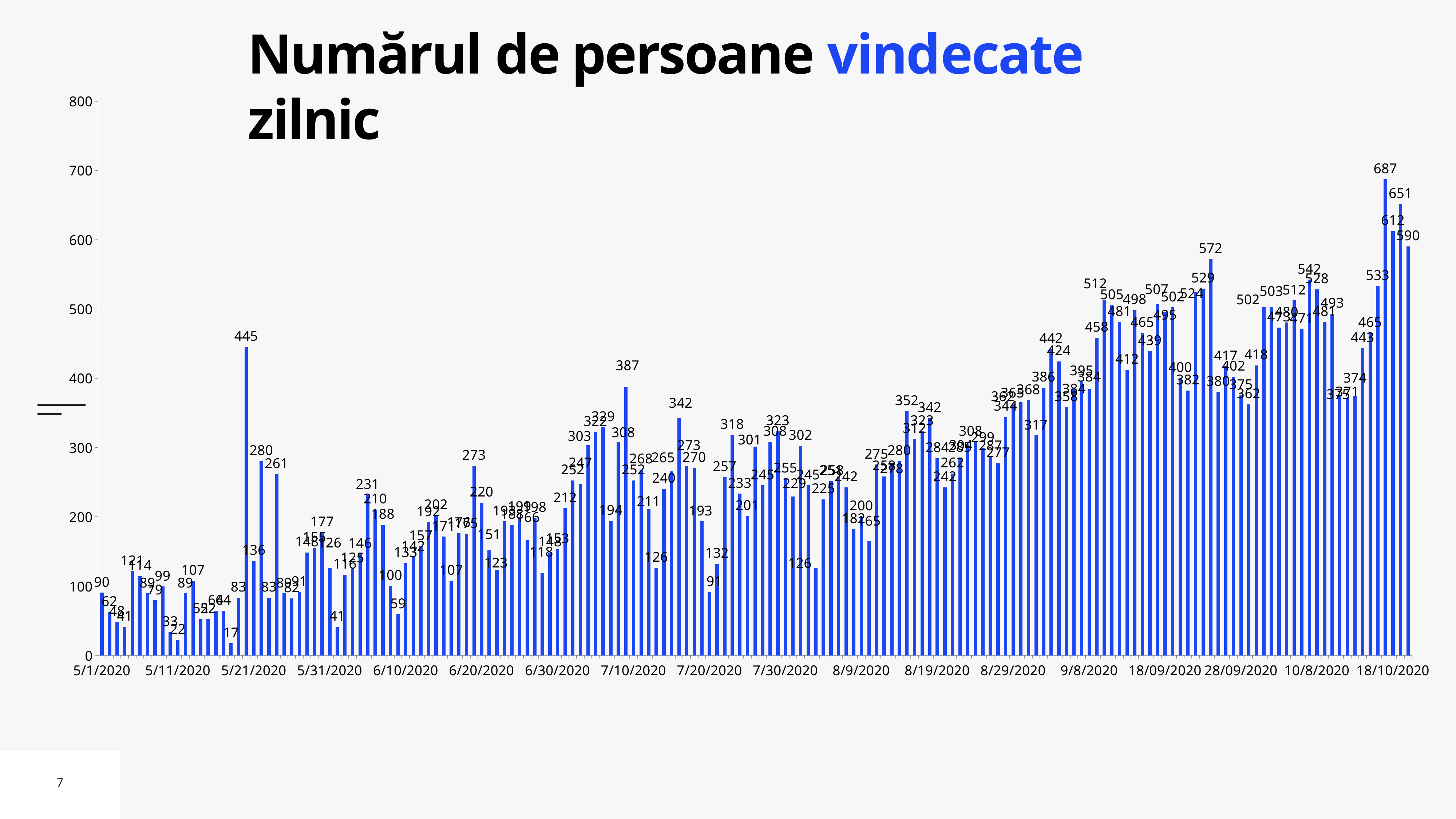
What is the value for 7/10/2020? 252 What is the highest daily value shown in the chart? 687 What is the difference between the value for 5/21/2020 and the value for 5/1/2020? 46 What is the value for 18/10/2020? 612 Do the values generally rise or fall from May 2020 to October 2020? rise What is the lowest daily value shown in the chart? 17 What kind of chart is shown on the slide? bar chart What is the value for 5/1/2020? 90 Is the value for 9/8/2020 greater or less than 300? greater What is the title of the chart? Numărul de persoane vindecate zilnic Which is larger, the value for 5/21/2020 or the value for 7/10/2020? 7/10/2020 What is the value for 5/21/2020? 136